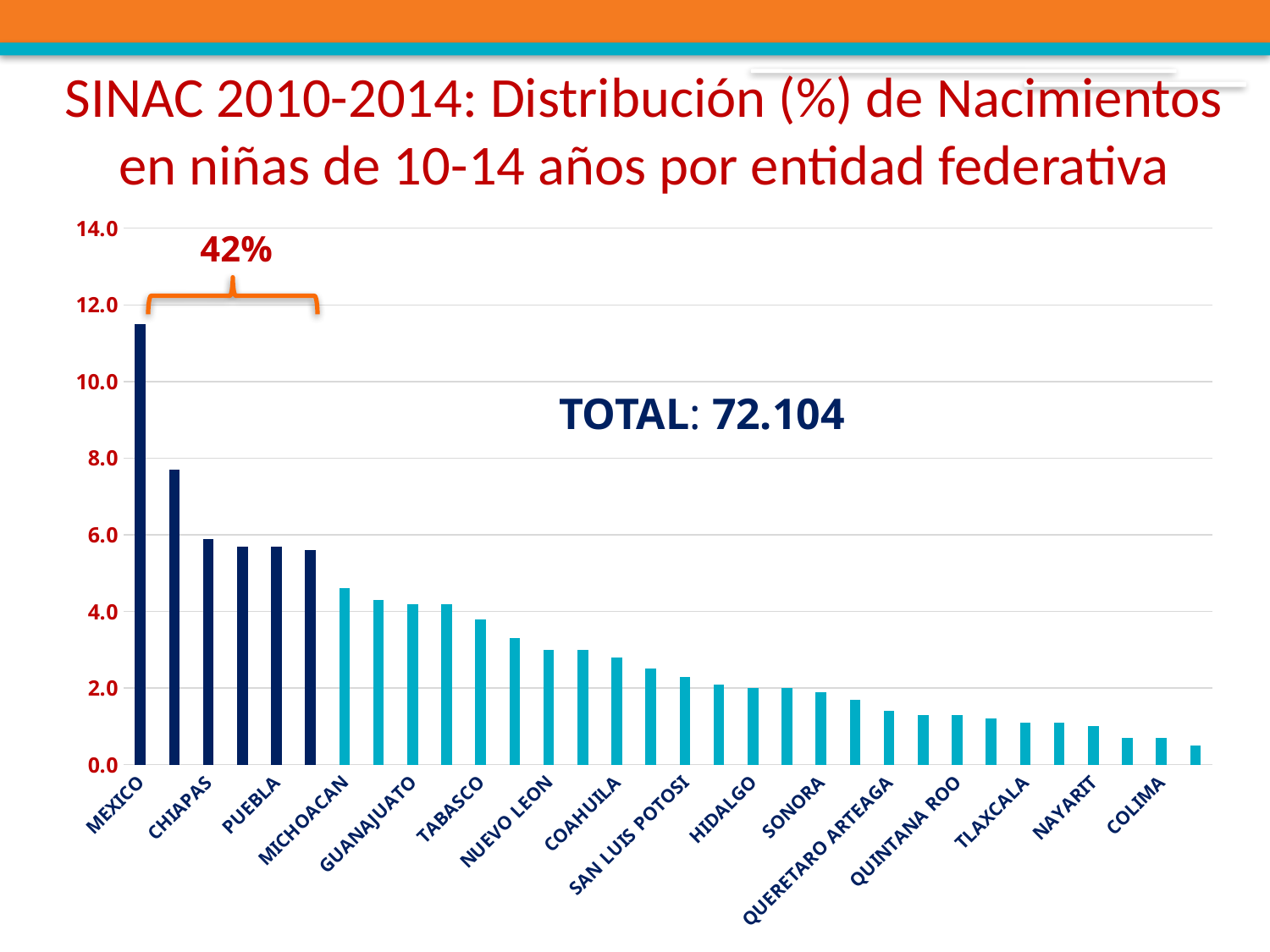
What kind of chart is shown on the slide? bar chart What total is printed on the chart? 72.104 Is the value for COLIMA greater or less than 2.0? less Do the values rise or fall from left to right along the x axis? fall Which has a larger value, PUEBLA or GUANAJUATO? PUEBLA Is the value for MEXICO greater or less than 10.0? greater Which has a larger value, MEXICO or CHIAPAS? MEXICO Which entity has the highest value in the chart? MEXICO Is the value for GUANAJUATO greater or less than 6.0? less What percentage is shown above the bracket covering the first bars of the chart? 42%